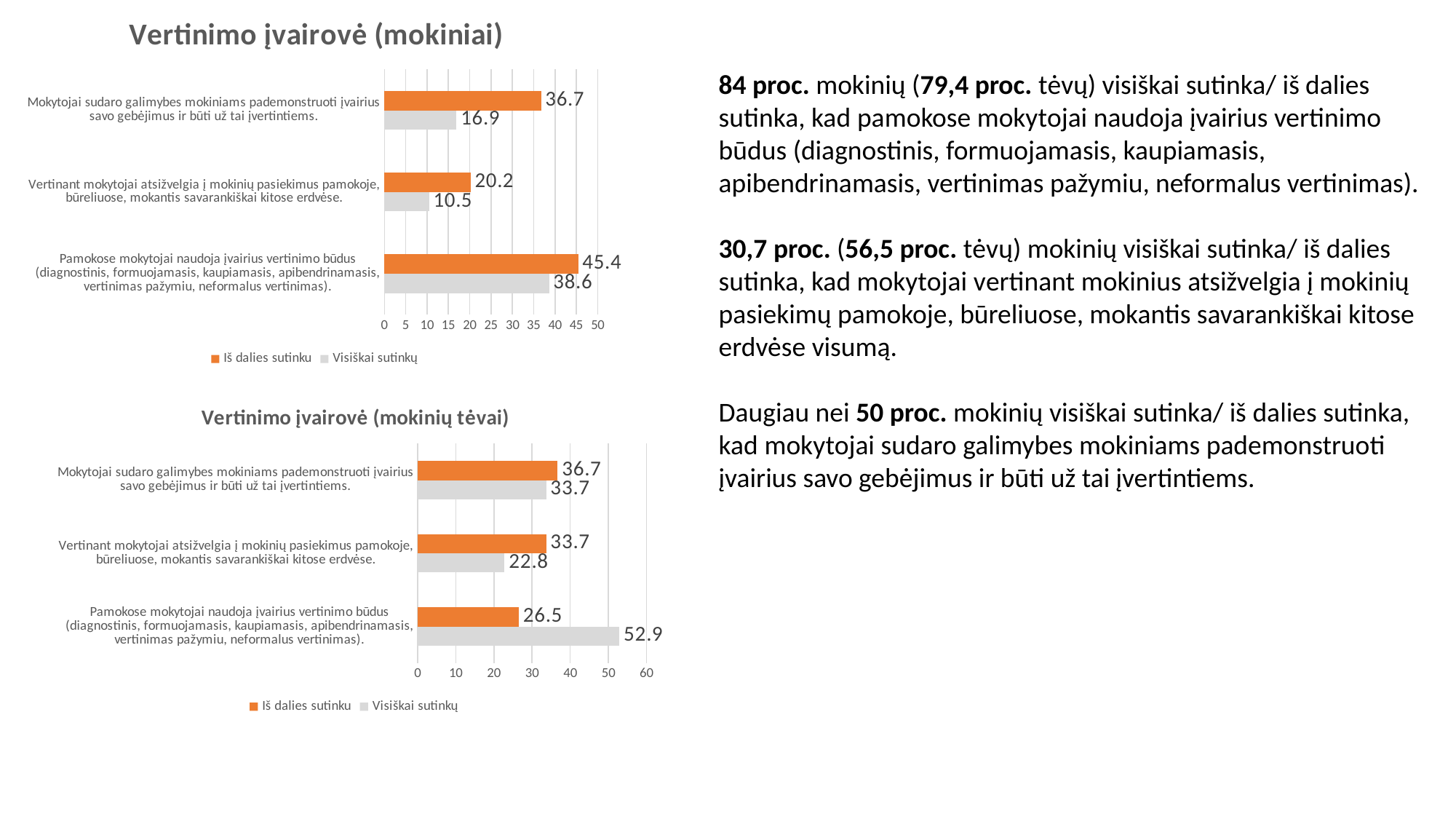
In the chart 'Vertinimo įvairovė (mokinių tėvai)', which is larger for 'Vertinant mokytojai atsižvelgia į mokinių pasiekimus pamokoje, būreliuose, mokantis savarankiškai kitose erdvėse': 'Iš dalies sutinku' or 'Visiškai sutinku'? Iš dalies sutinku How many series does the legend of the chart 'Vertinimo įvairovė (mokinių tėvai)' list? 2 In the chart 'Vertinimo įvairovė (mokiniai)', what is the 'Iš dalies sutinku' value for 'Pamokose mokytojai naudoja įvairius vertinimo būdus'? 45.4 In the chart 'Vertinimo įvairovė (mokiniai)', what is the difference between the 'Iš dalies sutinku' and 'Visiškai sutinku' values for 'Mokytojai sudaro galimybes mokiniams pademonstruoti įvairius savo gebėjimus ir būti už tai įvertintiems'? 19.8 How many categories are shown in the chart 'Vertinimo įvairovė (mokiniai)'? 3 In the chart 'Vertinimo įvairovė (mokiniai)', which category has the highest 'Visiškai sutinku' value? Pamokose mokytojai naudoja įvairius vertinimo būdus In the chart 'Vertinimo įvairovė (mokinių tėvai)', what is the difference between the 'Visiškai sutinku' and 'Iš dalies sutinku' values for 'Pamokose mokytojai naudoja įvairius vertinimo būdus'? 26.4 In the chart 'Vertinimo įvairovė (mokinių tėvai)', which category has the lowest 'Iš dalies sutinku' value? Pamokose mokytojai naudoja įvairius vertinimo būdus In the chart 'Vertinimo įvairovė (mokinių tėvai)', what is the 'Visiškai sutinku' value for 'Pamokose mokytojai naudoja įvairius vertinimo būdus'? 52.9 In the chart 'Vertinimo įvairovė (mokinių tėvai)', what is the 'Iš dalies sutinku' value for 'Mokytojai sudaro galimybes mokiniams pademonstruoti įvairius savo gebėjimus ir būti už tai įvertintiems'? 36.7 In the chart 'Vertinimo įvairovė (mokiniai)', what is the 'Visiškai sutinku' value for 'Vertinant mokytojai atsižvelgia į mokinių pasiekimus pamokoje, būreliuose, mokantis savarankiškai kitose erdvėse'? 10.5 What type of chart is 'Vertinimo įvairovė (mokiniai)'? Bar chart